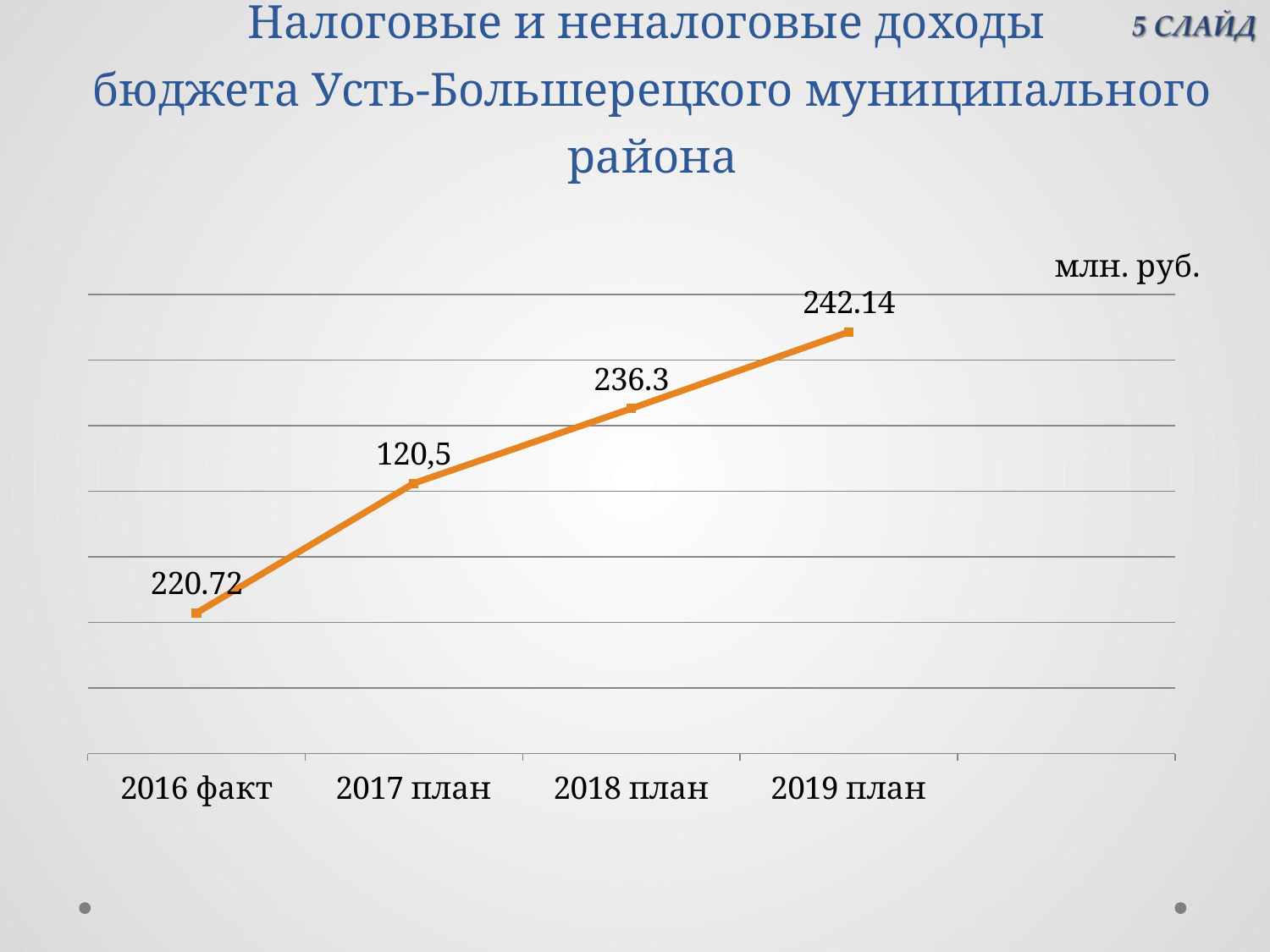
What is the difference between the values for 2018 план and 2016 факт? 15.58 What is the value for 2018 план? 236.3 What is the value for 2019 план? 242.14 What type of chart is shown on the slide? line chart What unit of measurement is indicated on the chart? млн. руб. How many data points are plotted on the chart? 4 What is the difference between the values for 2019 план and 2018 план? 5.84 Which is larger, the value for 2016 факт or the value for 2018 план? 2018 план Which category has the highest value? 2019 план What is the value for 2016 факт? 220.72 Which is larger, the value for 2019 план or the value for 2018 план? 2019 план Do the values rise or fall from 2016 факт to 2019 план? rise